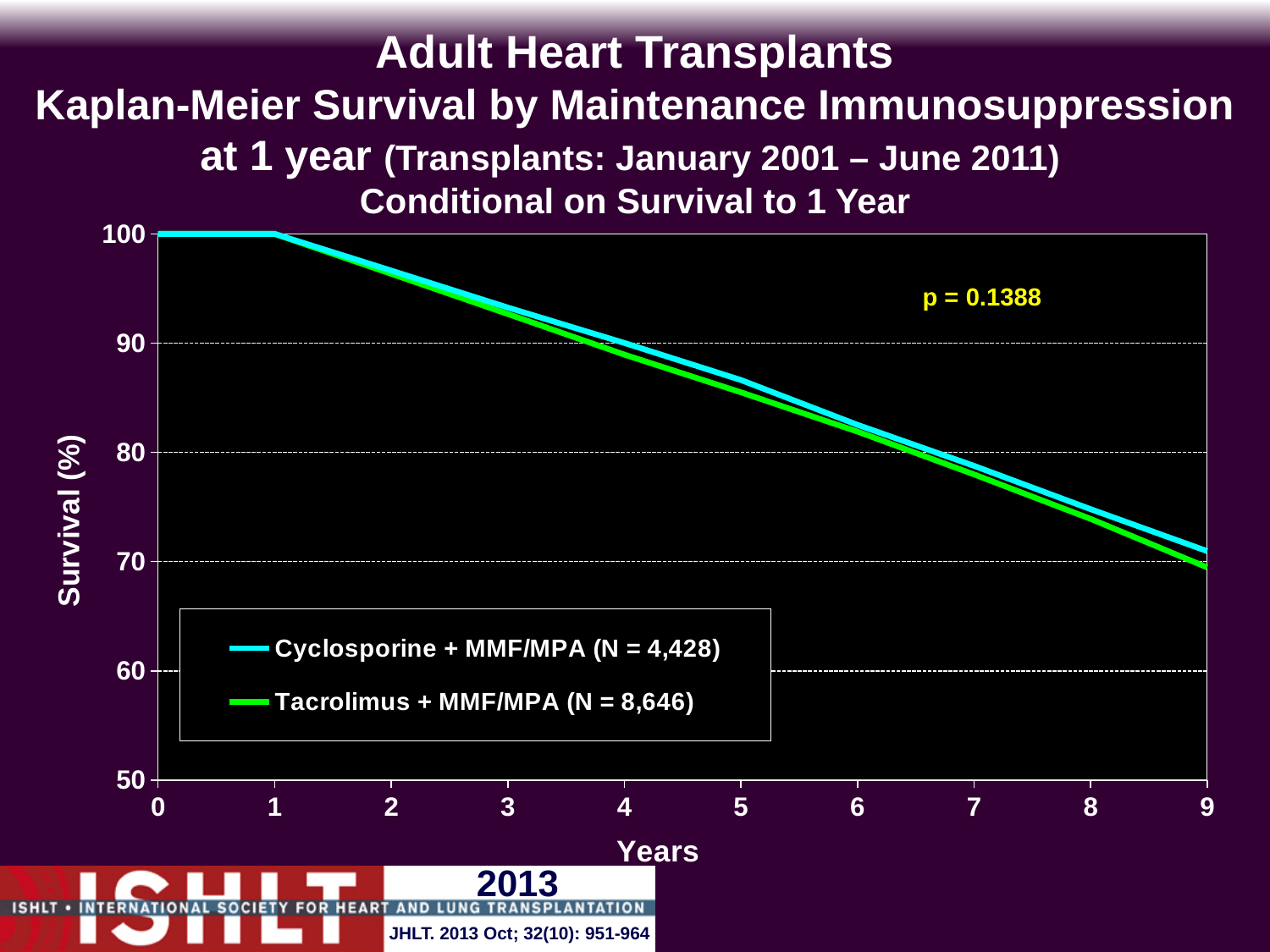
What is the survival (%) for both series at 1 year? 100 Is the survival for Tacrolimus + MMF/MPA at 8 years greater or less than 80? less What kind of chart is shown on the slide? line chart Is the survival for Tacrolimus + MMF/MPA at 2 years greater or less than 90? greater What is the label of the y axis? Survival (%) How many series does the legend list? 2 Do the survival curves rise or fall as years increase? fall At 9 years, which series has the higher survival: Cyclosporine + MMF/MPA or Tacrolimus + MMF/MPA? Cyclosporine + MMF/MPA What p-value is printed on the chart? p = 0.1388 Is the survival for Cyclosporine + MMF/MPA at 5 years greater or less than 80? greater What is the N shown in the legend for Tacrolimus + MMF/MPA? 8,646